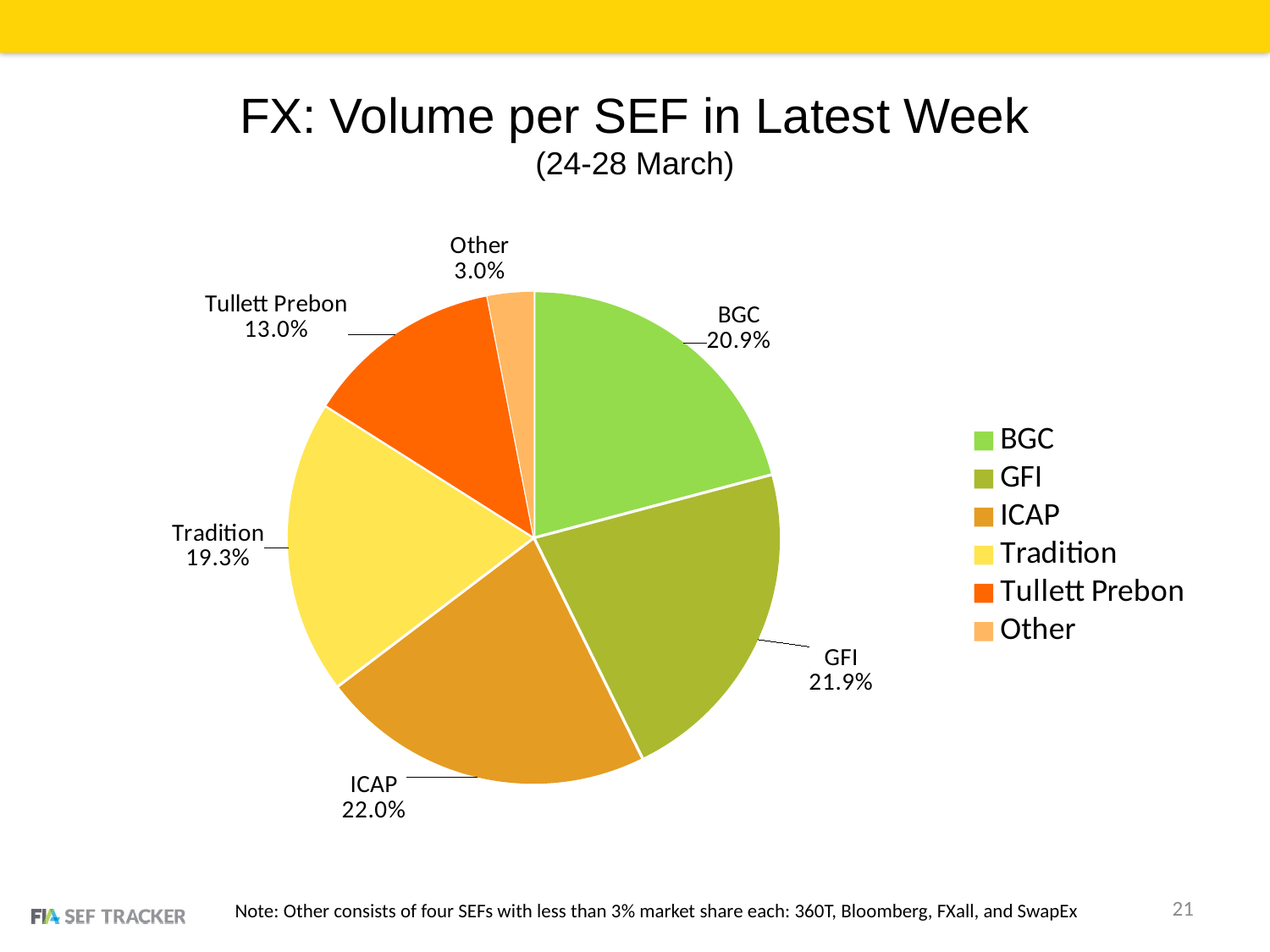
How many slices does the pie chart have? 6 What share of FX volume does Tullett Prebon have? 13.0% What share of FX volume does BGC have? 20.9% Which has a larger share, Tradition or Tullett Prebon? Tradition What share of FX volume does Tradition have? 19.3% What is the difference in share between BGC and Tradition? 1.6% What is the title of the chart? FX: Volume per SEF in Latest Week (24-28 March) What share of FX volume does the Other slice represent? 3.0% What kind of chart is shown on the slide? pie chart Which named SEF (excluding Other) has the smallest share of FX volume? Tullett Prebon Which SEF has the smallest share of FX volume? Other What is the difference in share between ICAP and Tullett Prebon? 9.0%